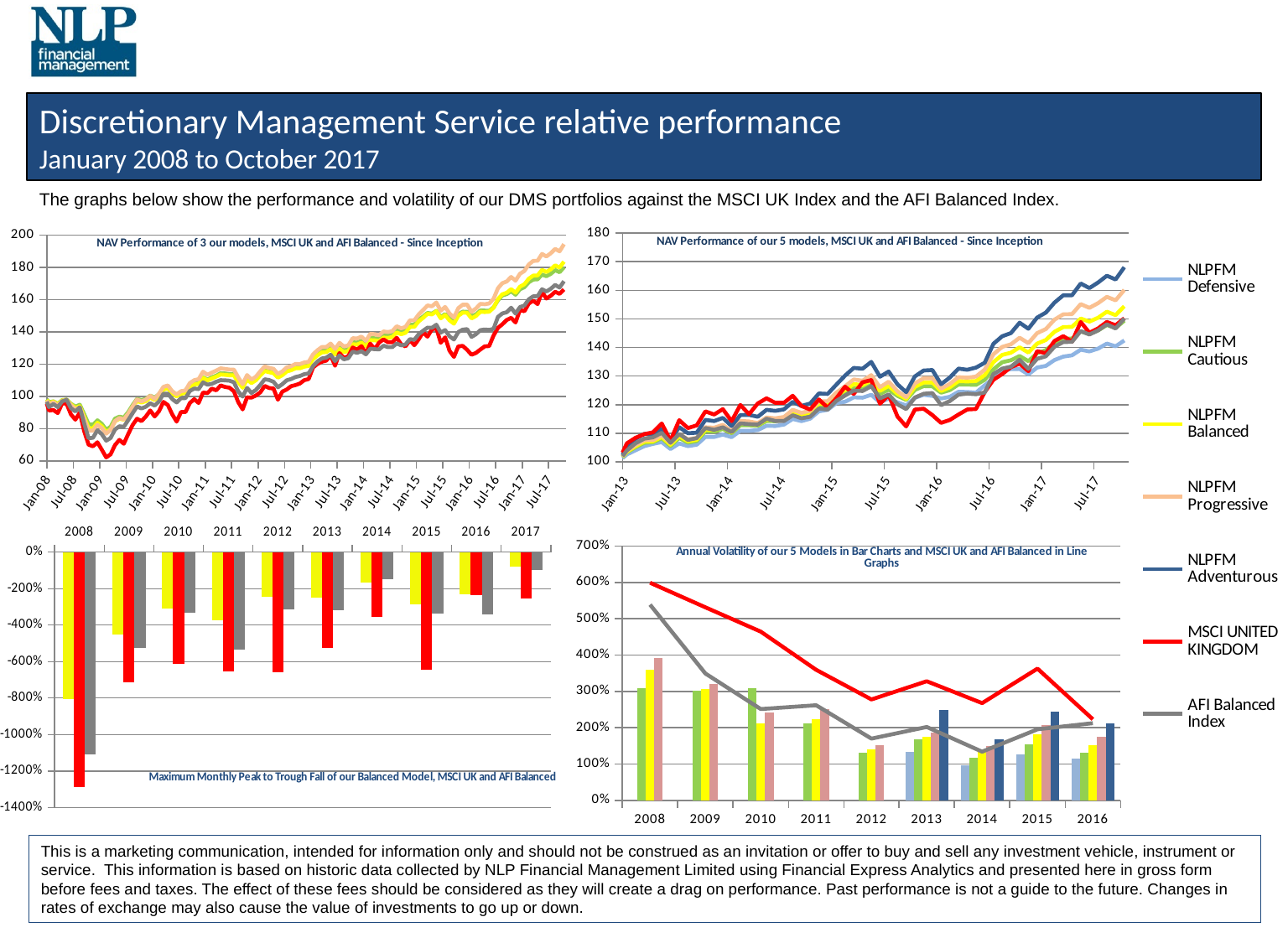
What kind of chart is the 'Maximum Monthly Peak to Trough Fall of our Balanced Model, MSCI UK and AFI Balanced' chart? Bar chart In the 'Annual Volatility of our 5 Models' chart, how many years are shown on the x axis? 9 In the 'NAV Performance of 3 our models' chart, which series is highest at Jul-17? NLPFM Progressive In the 'Maximum Monthly Peak to Trough Fall' chart, how many years are shown on the x axis? 10 In the 'NAV Performance of our 5 models' chart, which series is highest at the end of the period (Jul-17)? NLPFM Adventurous What kind of chart is the 'NAV Performance of 3 our models, MSCI UK and AFI Balanced - Since Inception' chart? Line chart In the 'Annual Volatility of our 5 Models' chart, does the MSCI UNITED KINGDOM line rise or fall from 2008 to 2012? Fall In the 'Annual Volatility of our 5 Models' chart, is the MSCI UNITED KINGDOM value for 2008 greater or less than 500%? greater How many series does the legend on the right of the slide list? 7 In the 'Maximum Monthly Peak to Trough Fall' chart, which series has the largest fall in 2008? MSCI UNITED KINGDOM In the 'NAV Performance of our 5 models' chart, is the NLPFM Adventurous value at Jul-17 greater or less than 160? greater In the 'Maximum Monthly Peak to Trough Fall' chart, is the value for MSCI UNITED KINGDOM in 2008 greater or less than -1200%? less